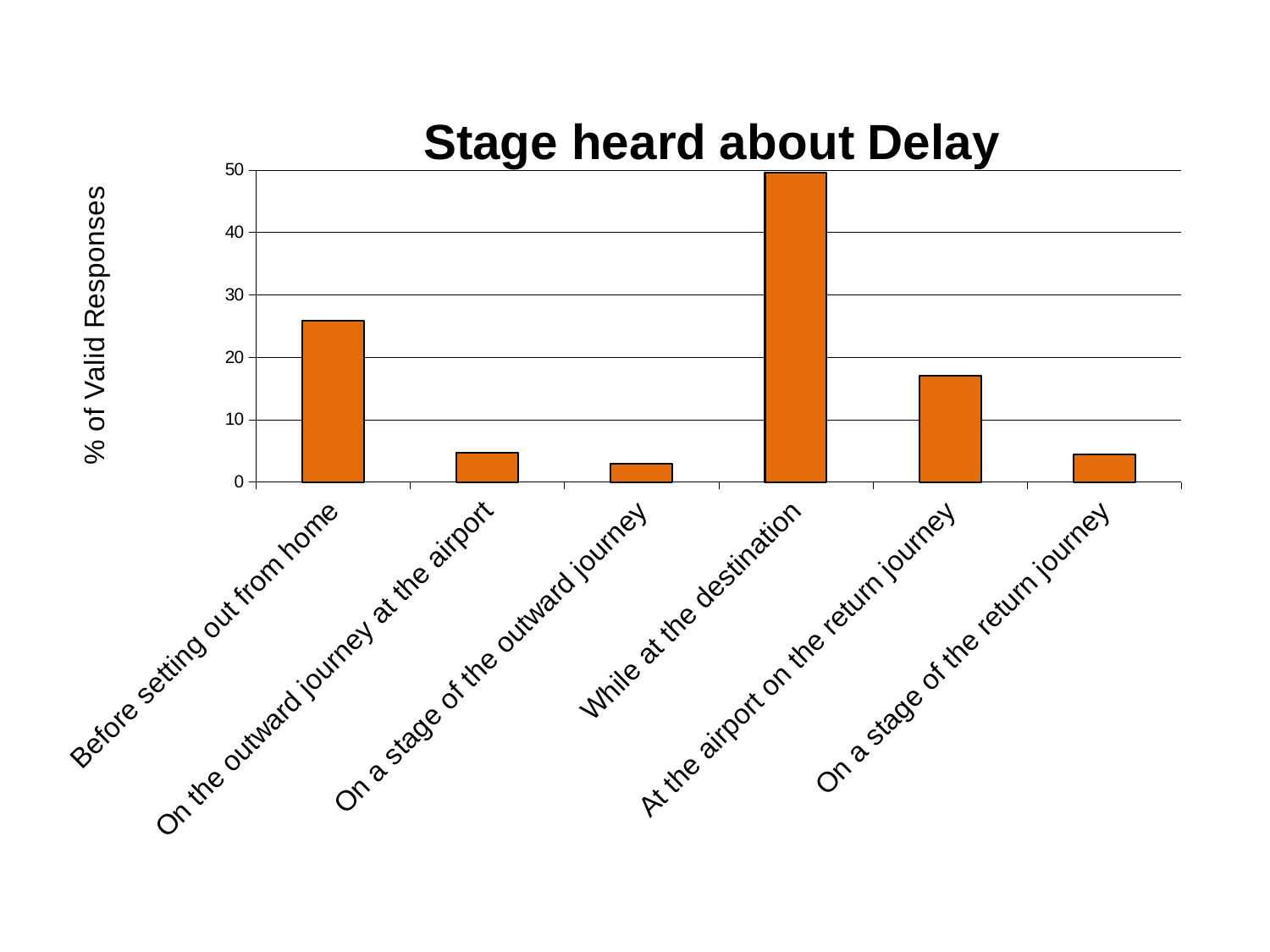
Is the value for 'At the airport on the return journey' greater or less than 20? less What kind of chart is shown on the slide? bar chart Is the value for 'Before setting out from home' greater or less than 30? less What is the title of the chart? Stage heard about Delay Is the value for 'While at the destination' greater or less than 40? greater What is the label on the y axis of the chart? % of Valid Responses How many categories are shown on the x axis of the chart? 6 Which is larger: the value for 'Before setting out from home' or the value for 'At the airport on the return journey'? Before setting out from home Which is larger: the value for 'While at the destination' or the value for 'On the outward journey at the airport'? While at the destination Which category has the highest value in the chart? While at the destination